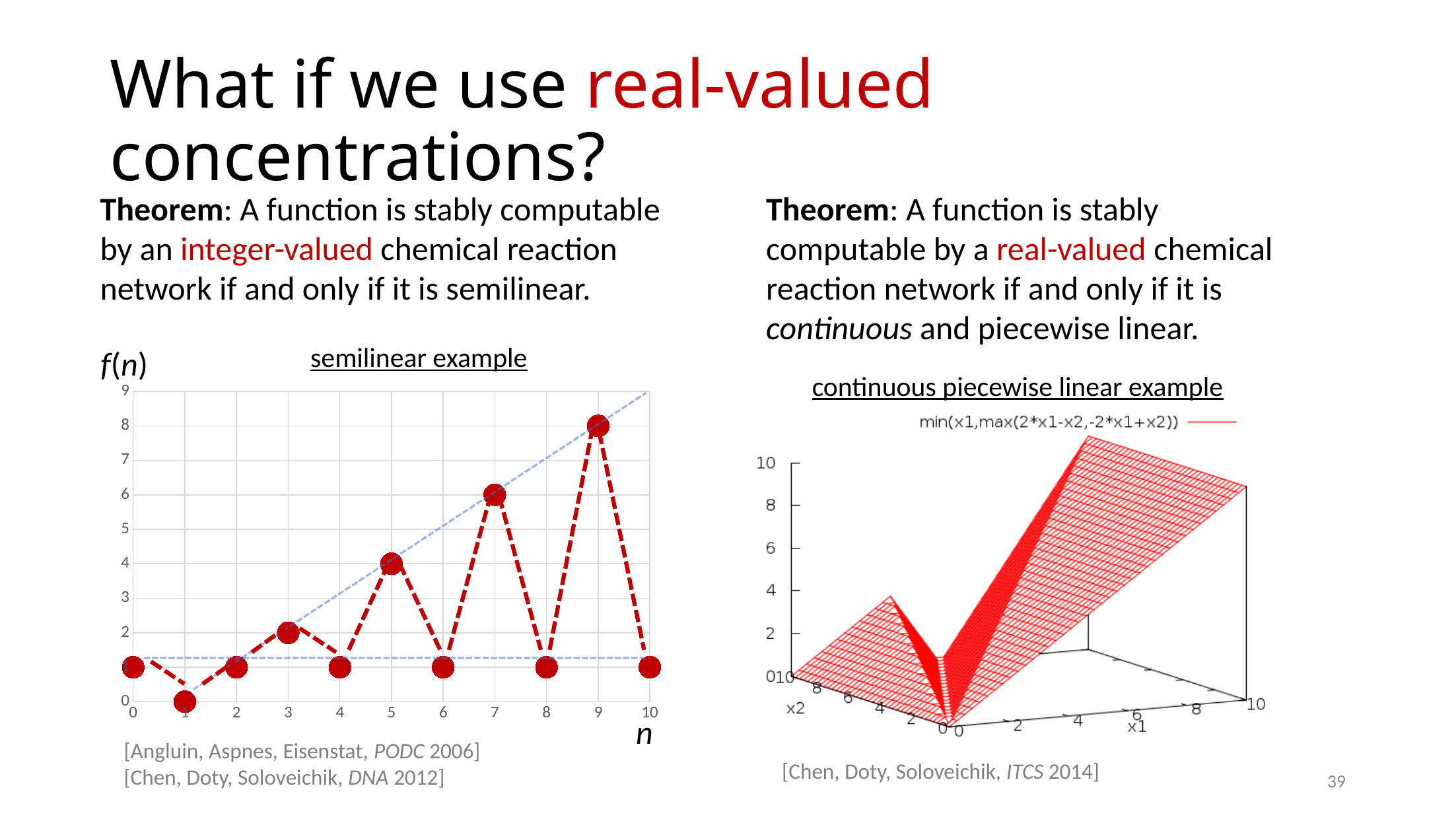
In the 'semilinear example' chart, what is the value of f(n) at n = 9? 8 In the 'semilinear example' chart, what is the value of f(n) at n = 1? 0 In the 'semilinear example' chart, at which value of n is f(n) lowest? 1 In the 'semilinear example' chart, is the value of f(n) at n = 9 greater or less than 5? greater How many data points are plotted in the 'semilinear example' chart? 11 What kind of chart is the 'semilinear example' chart? line chart In the 'semilinear example' chart, which is larger, f(5) or f(3)? f(5) In the 'semilinear example' chart, what is the difference between f(9) and f(7)? 2 In the 'semilinear example' chart, at which value of n is f(n) highest? 9 In the 'semilinear example' chart, what is the value of f(n) at n = 7? 6 What kind of chart is the 'continuous piecewise linear example' chart? 3D surface plot What function is named in the legend of the 'continuous piecewise linear example' chart? min(x1,max(2*x1-x2,-2*x1+x2))